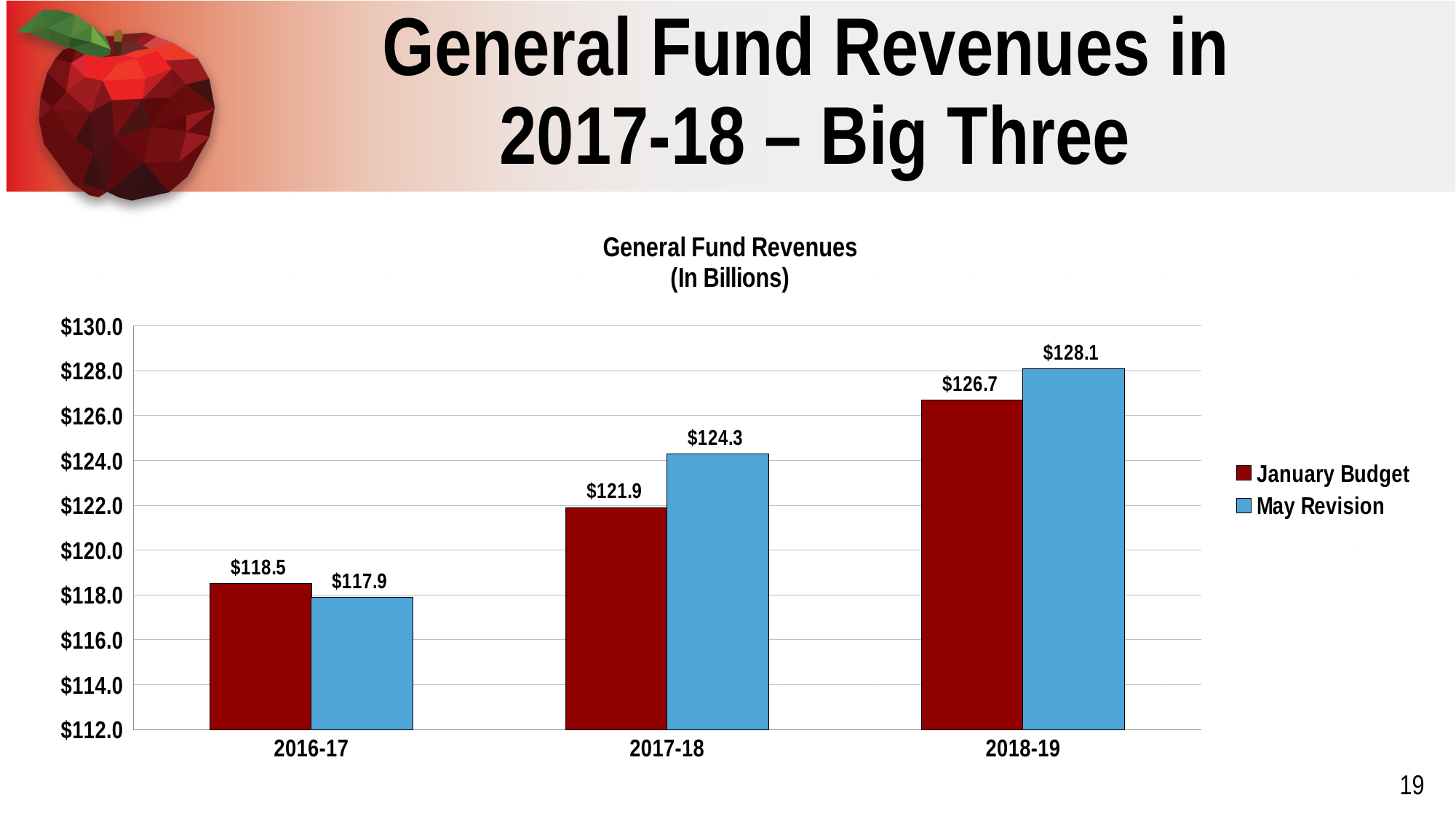
Is the January Budget value for 2018-19 greater or less than $126.0? greater For 2016-17, which is larger: the January Budget or the May Revision value? January Budget What is the May Revision value for 2018-19? $128.1 How many fiscal years are shown on the x axis? 3 Which fiscal year has the lowest January Budget value? 2016-17 Do the May Revision values rise or fall from 2016-17 to 2018-19? Rise What is the difference between the May Revision and January Budget values for 2017-18? $2.4 What kind of chart is shown on the slide? Bar chart How many series does the legend list? 2 Which fiscal year has the highest May Revision value? 2018-19 What is the May Revision value for 2016-17? $117.9 What is the January Budget value for 2017-18? $121.9